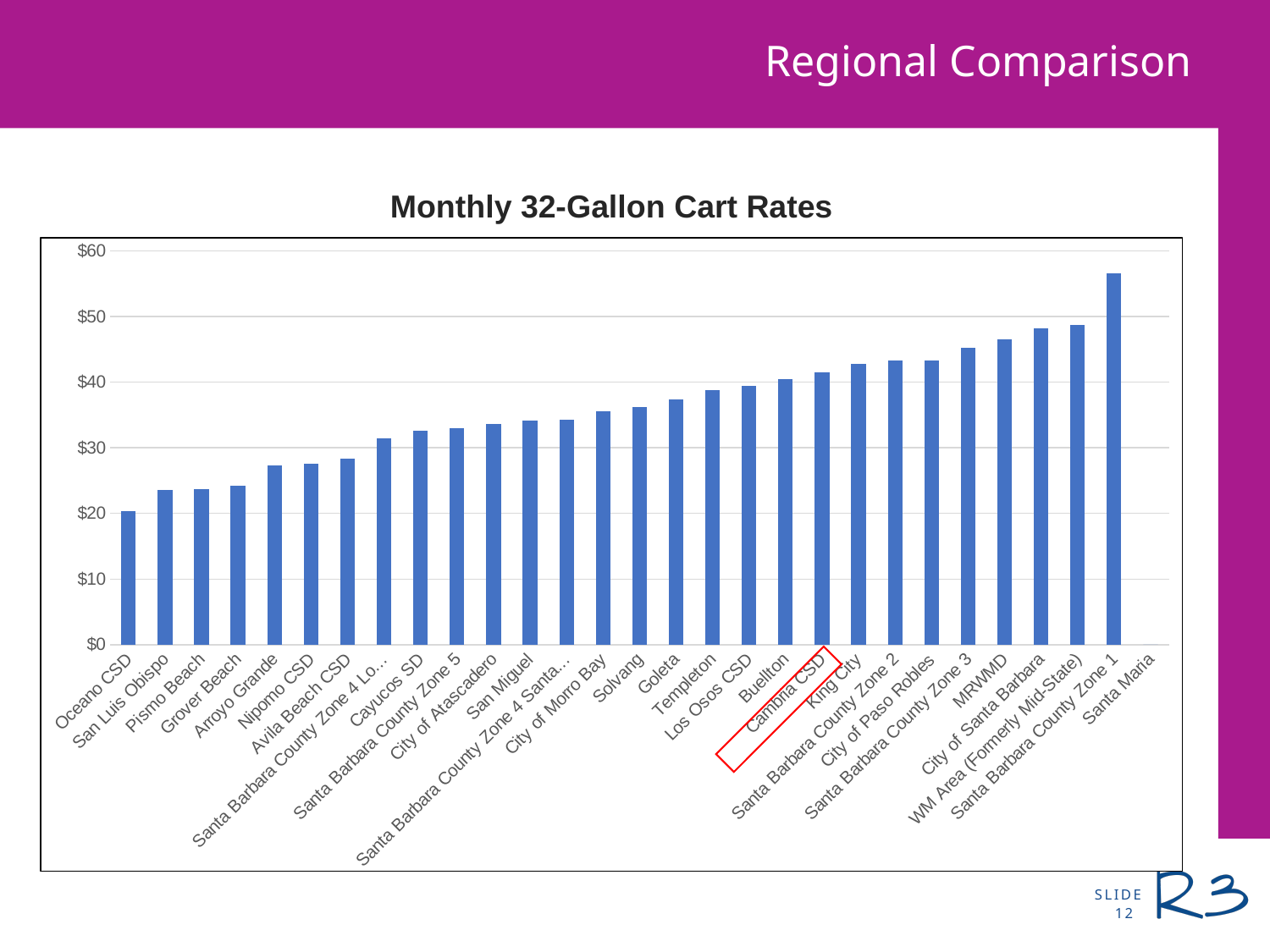
Is the value for Arroyo Grande greater or less than $30? less Is the value for Goleta greater or less than $40? less Which category label is outlined with a red box on the chart? Cambria CSD Is the value for Goleta greater or less than $30? greater What kind of chart is shown on the slide? bar chart What is the title of the chart? Monthly 32-Gallon Cart Rates Which has a higher monthly cart rate, Oceano CSD or King City? King City Do the bar values generally rise or fall from left to right along the x axis? rise